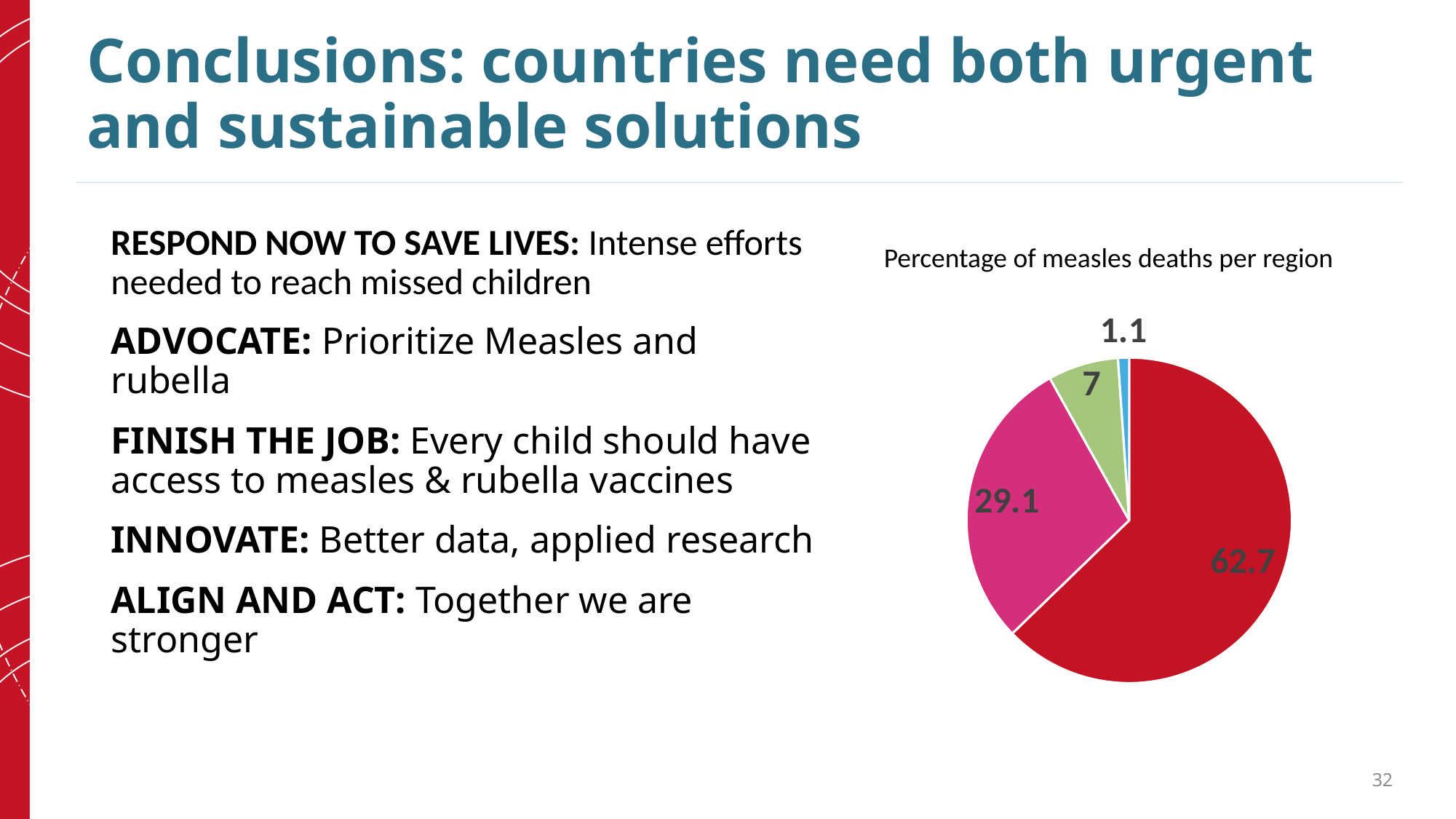
What value is labelled on the blue slice of the pie chart? 1.1 What is the difference between the largest slice (62.7) and the second-largest slice (29.1)? 33.6 What is the difference between the slices labelled 7 and 1.1? 5.9 What colour is the largest slice of the pie chart? red What is the value of the smallest slice in the pie chart? 1.1 Which slice is larger, the one labelled 29.1 or the one labelled 7? 29.1 What value is labelled on the green slice of the pie chart? 7 What kind of chart is shown on the slide? pie chart What is the title of the chart? Percentage of measles deaths per region What value is labelled on the pink slice of the pie chart? 29.1 What is the value of the largest slice in the pie chart? 62.7 How many slices does the pie chart have? 4